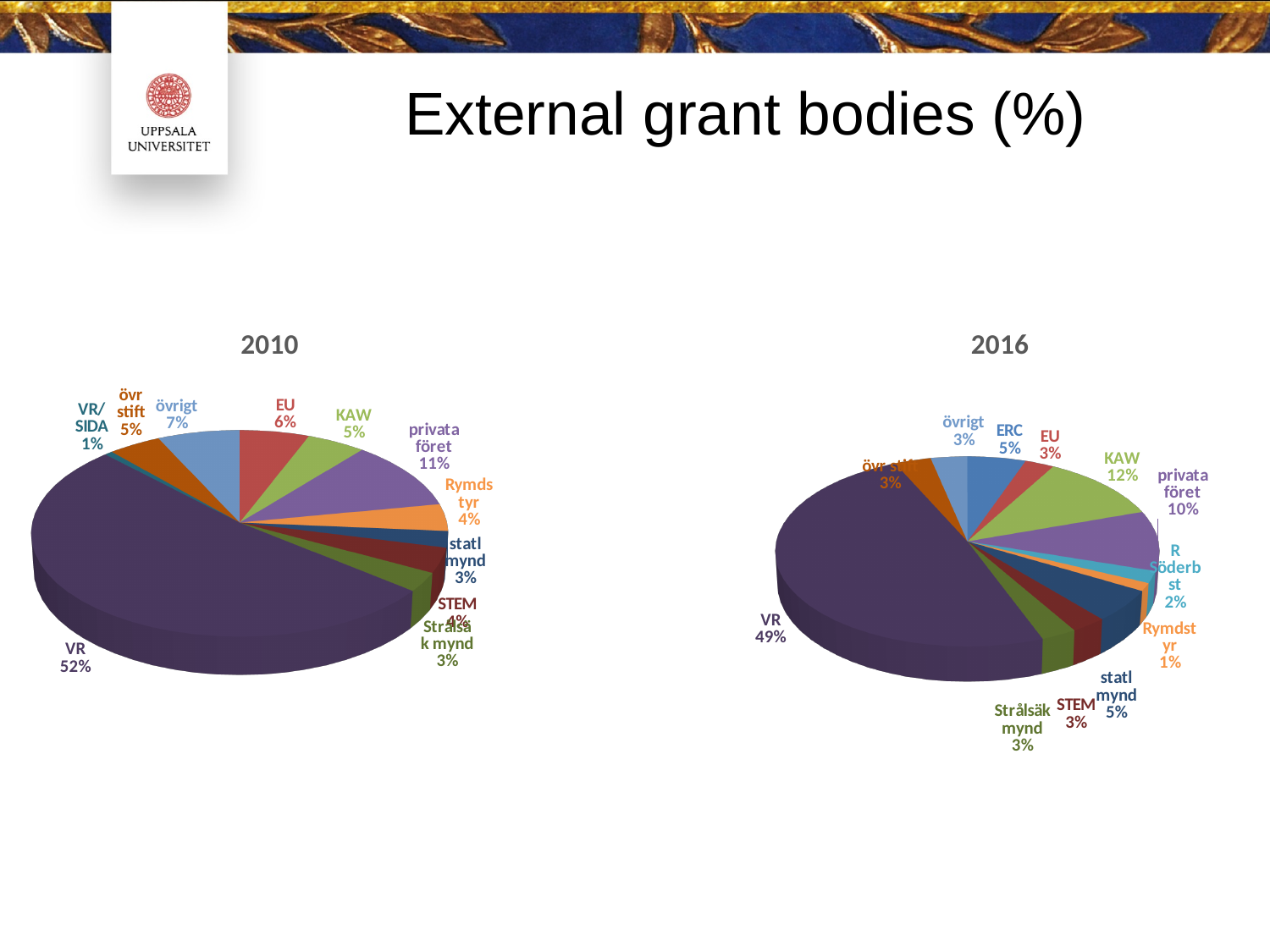
What type of chart is used on this slide? Pie chart In the 2010 pie chart, what share does VR have? 52% What is the title of the slide? External grant bodies (%) What is the difference between the KAW share in 2016 and the KAW share in 2010? 7% In the 2016 pie chart, which is larger, the share for KAW or the share for privata föret? KAW In the 2016 pie chart, what share does ERC have? 5% In the 2010 pie chart, which grant body has the largest share? VR In the 2016 pie chart, what share does KAW have? 12% In the 2010 pie chart, what share does privata föret have? 11% In the 2016 pie chart, which grant body has the smallest share? Rymdstyr In the 2016 pie chart, what share does VR have? 49% In the 2010 pie chart, which grant body has the smallest share? VR/SIDA